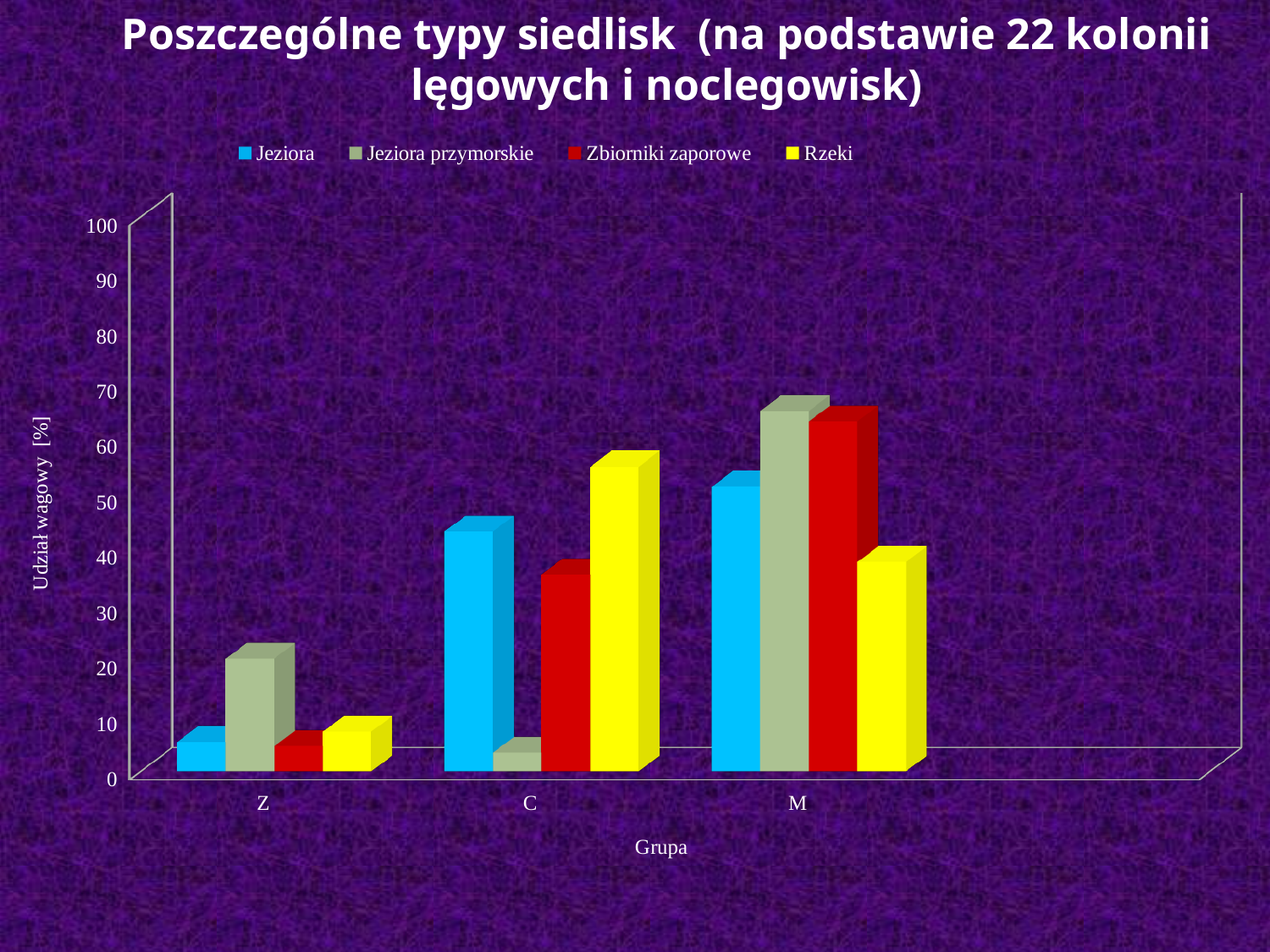
Is the value for Jeziora przymorskie in group C greater or less than 10? less For the Jeziora series, which group has the highest value? M What kind of chart is shown on the slide? bar chart How many series does the legend list? 4 What is the label of the y axis? Udział wagowy [%] In group Z, which is larger: Jeziora przymorskie or Jeziora? Jeziora przymorskie Is the value for Rzeki in group M greater or less than 50? less How many groups (categories) are shown on the x axis? 3 Is the value for Jeziora in group C greater or less than 30? greater Which series has the highest value in group C? Rzeki For the Jeziora przymorskie series, which group has the lowest value? C Which series has the lowest value in group C? Jeziora przymorskie